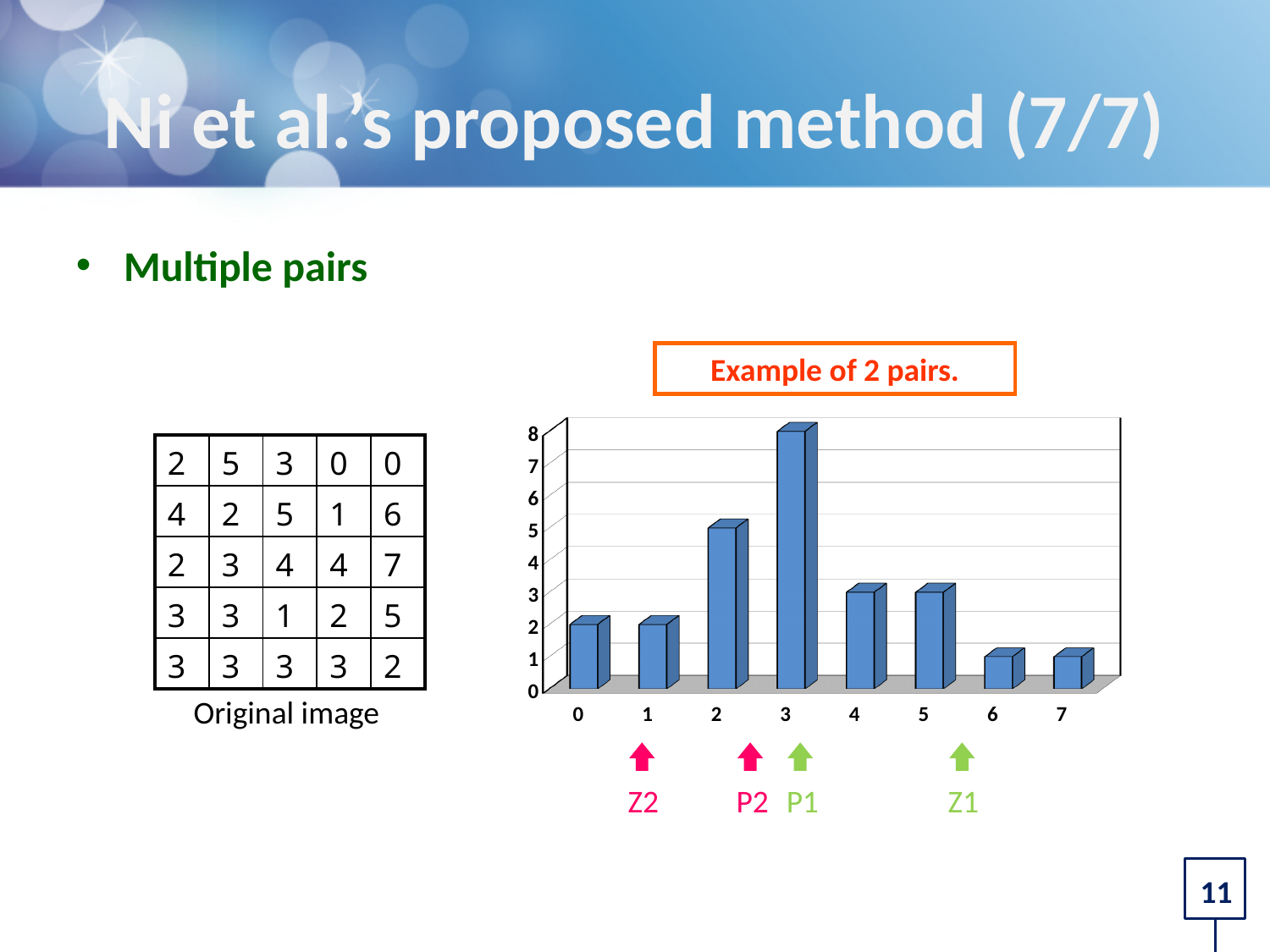
What is the value of the bar for category 2? 5 Is the value for category 2 greater or less than 4? greater What text is shown in the orange box above the chart? Example of 2 pairs. How many categories are shown on the x axis of the chart? 8 Is the value for category 3 greater or less than 7? greater What is the value of the bar for category 3? 8 Which is larger, the bar for category 5 or the bar for category 7? category 5 What is the difference between the bar for category 3 and the bar for category 2? 3 Is the value for category 6 greater or less than 2? less Which category has the highest bar in the chart? 3 Which is larger, the bar for category 2 or the bar for category 4? category 2 What kind of chart is shown on the slide? bar chart